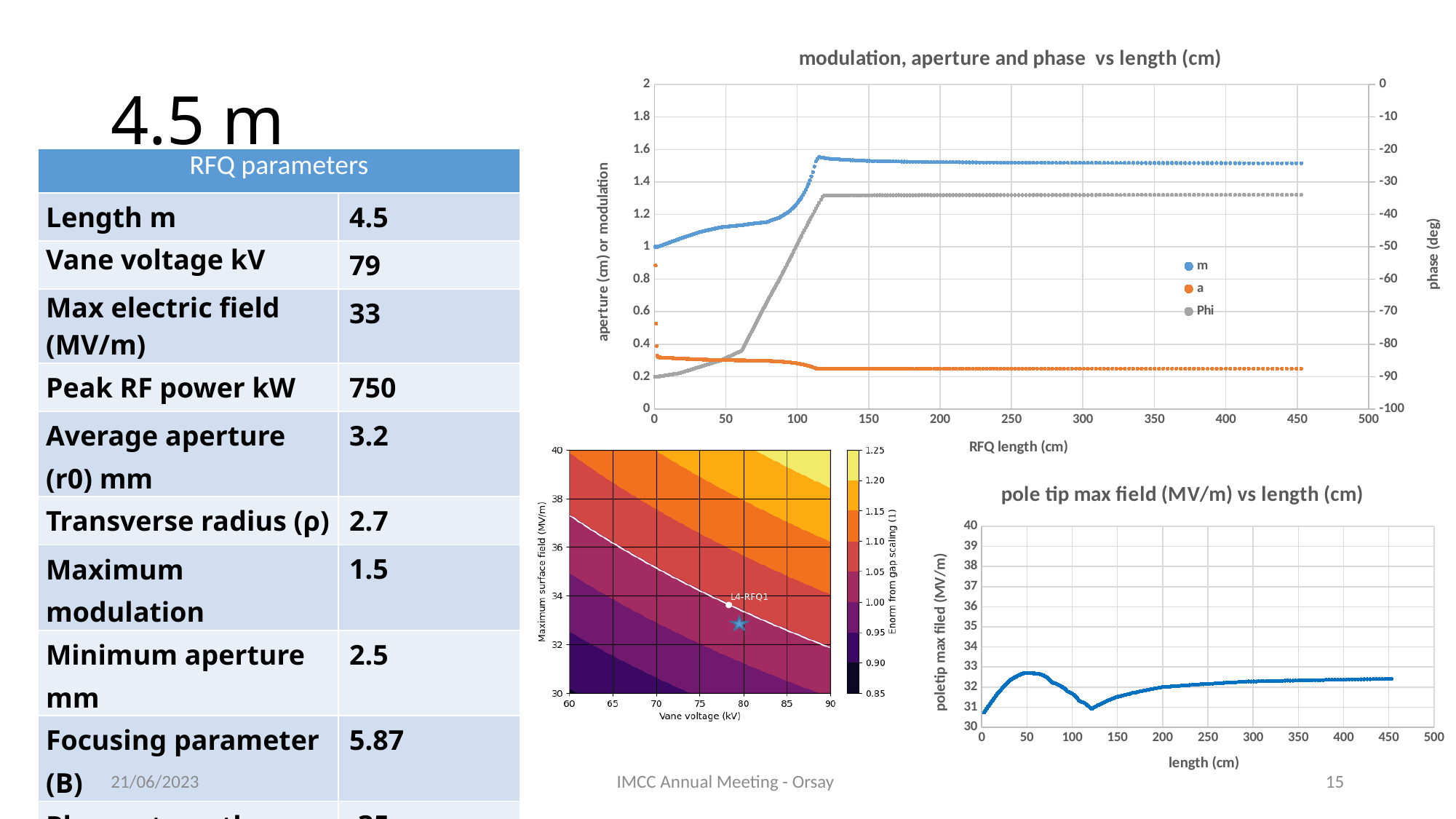
In the chart titled 'modulation, aperture and phase vs length (cm)', what are the names of the series in the legend? m, a, Phi In the chart titled 'pole tip max field (MV/m) vs length (cm)', is the value at 450 cm greater or less than 33? less In the chart titled 'pole tip max field (MV/m) vs length (cm)', is the value at 0 cm greater or less than 31? less In the chart titled 'modulation, aperture and phase vs length (cm)', which series has the higher value at 450 cm, m or a? m In the chart titled 'pole tip max field (MV/m) vs length (cm)', is the value at 450 cm greater or less than 32? greater In the chart titled 'modulation, aperture and phase vs length (cm)', does series m rise or fall between 0 and 100 cm? rise In the chart titled 'modulation, aperture and phase vs length (cm)', how many series does the legend list? 3 In the chart titled 'pole tip max field (MV/m) vs length (cm)', does the value rise or fall between 150 cm and 450 cm? rise In the chart titled 'pole tip max field (MV/m) vs length (cm)', which is larger, the value at 50 cm or the value at 120 cm? the value at 50 cm In the chart titled 'modulation, aperture and phase vs length (cm)', what is the label of the x axis? RFQ length (cm)